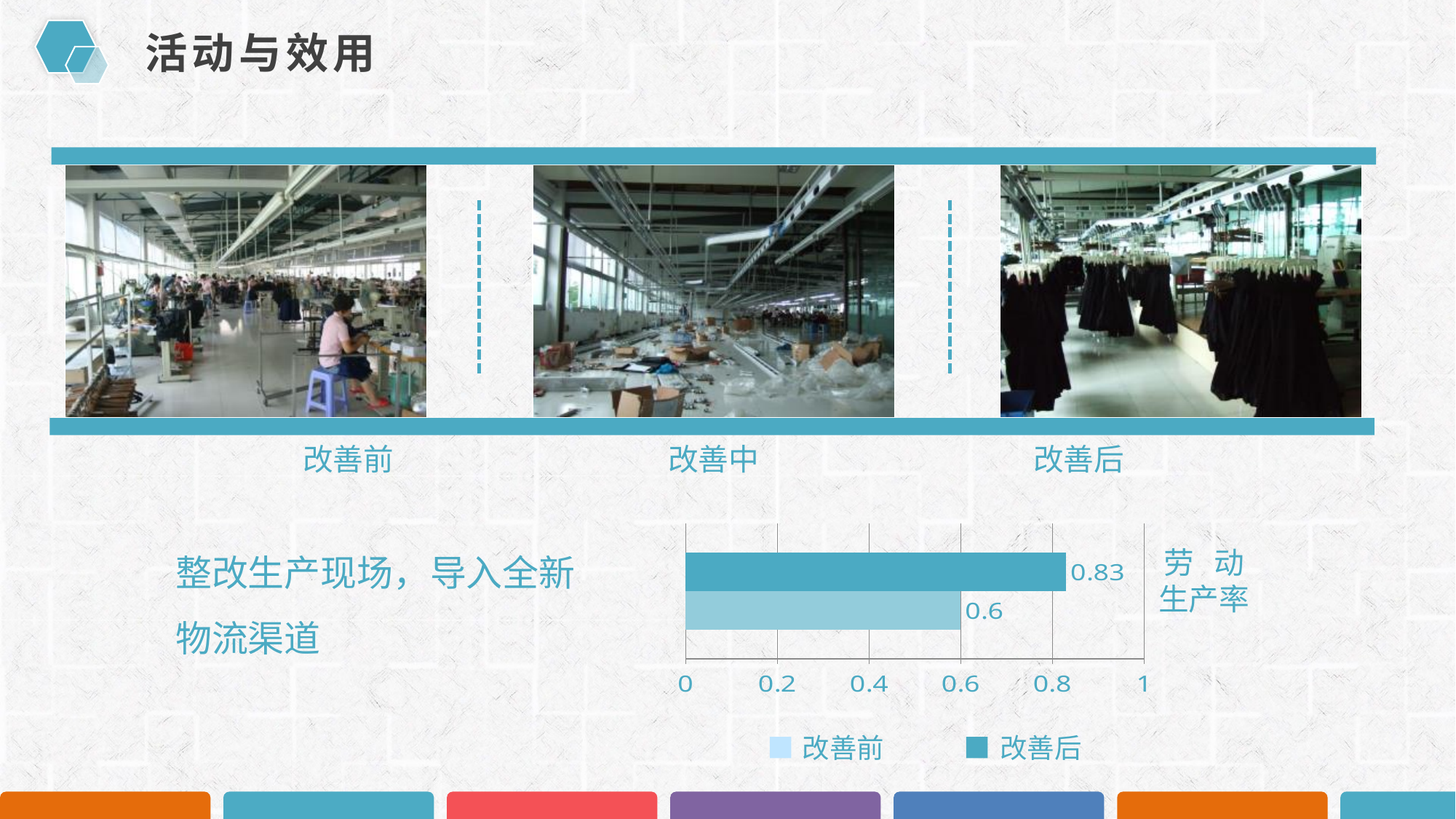
Which series has the higher value, 改善前 or 改善后? 改善后 What is the value for 改善后 in the chart? 0.83 What kind of chart is shown on the slide? bar chart Which series has the highest value in the chart? 改善后 Is the value for 改善后 greater or less than 0.8? greater Which series has the lowest value in the chart? 改善前 Is the value for 改善前 greater or less than 0.8? less What is the value for 改善前 in the chart? 0.6 What is the difference between the 改善后 value and the 改善前 value? 0.23 How many series does the legend list? 2 What label appears to the right of the bars in the chart? 劳动生产率 What is the maximum value shown on the chart's axis? 1